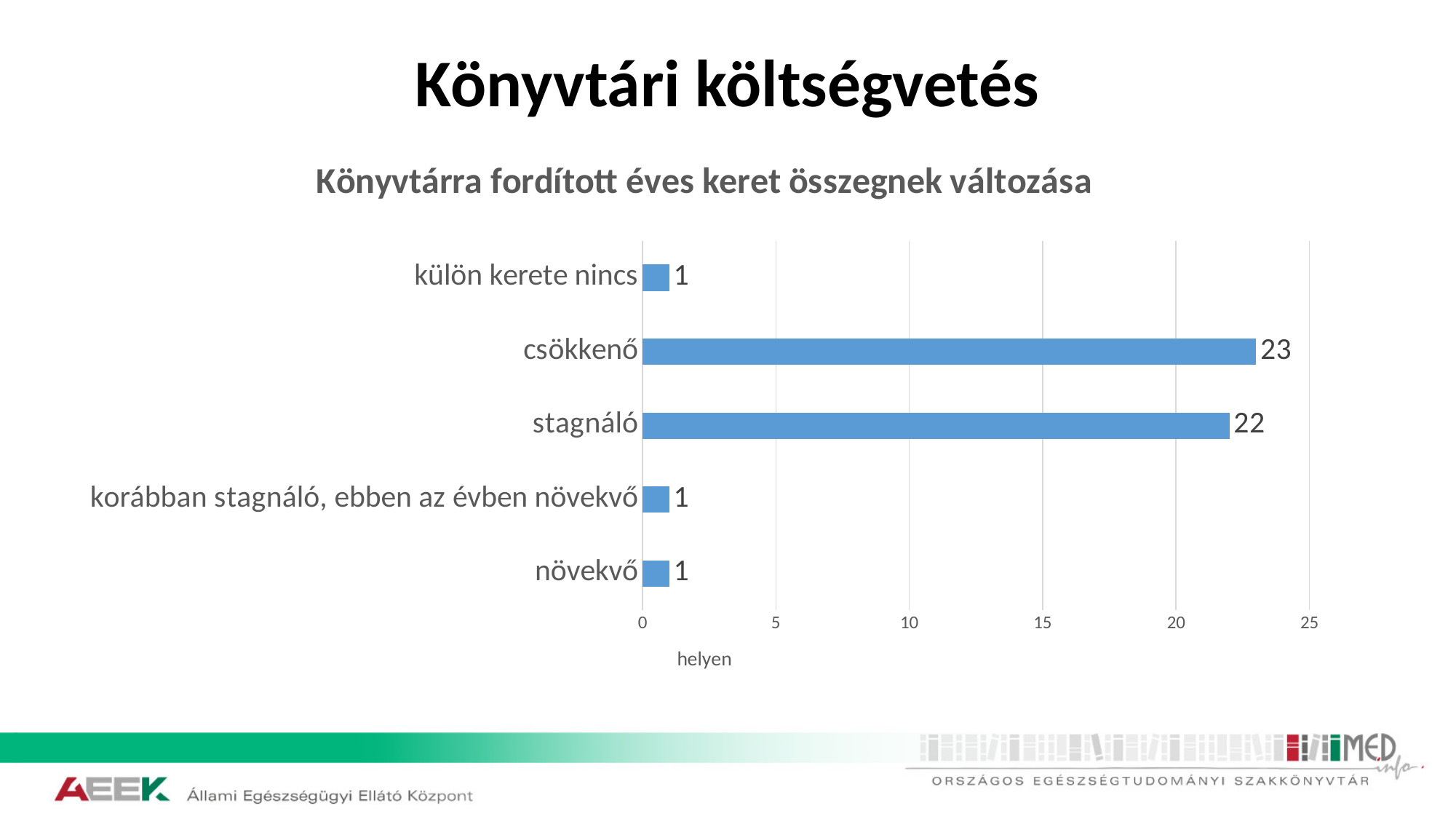
Which is larger, the value for "csökkenő" or the value for "növekvő"? csökkenő What is the value for "csökkenő"? 23 What is the value for "külön kerete nincs"? 1 What is the value for "korábban stagnáló, ebben az évben növekvő"? 1 What kind of chart is shown on the slide? bar chart What is the difference between the values for "stagnáló" and "növekvő"? 21 What is the title of the chart? Könyvtárra fordított éves keret összegnek változása What is the value for "stagnáló"? 22 What is the difference between the values for "csökkenő" and "stagnáló"? 1 Which category has the highest value? csökkenő How many categories are shown in the chart? 5 Is the value for "stagnáló" greater or less than 20? greater